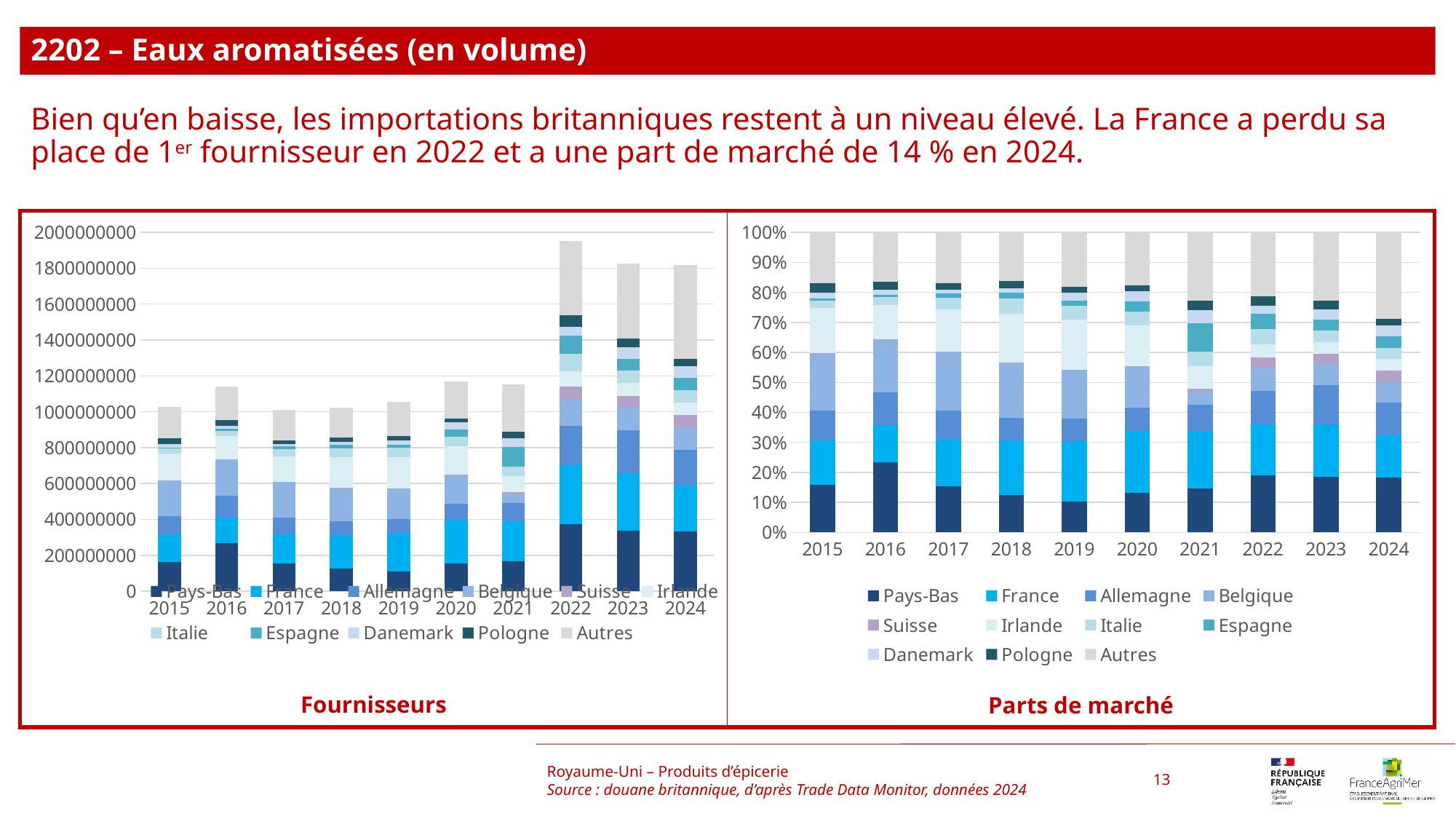
In the 'Fournisseurs' chart, is the total for 2023 greater or less than 1600000000? greater In the 'Parts de marché' chart, is the Pays-Bas share in 2016 greater or less than 20%? greater What is the title of the chart on the right side of the slide? Parts de marché What kind of chart is the 'Fournisseurs' chart on the left? stacked bar chart In the 'Fournisseurs' chart, which year has the larger total, 2021 or 2022? 2022 How many years are shown on the x axis of the 'Parts de marché' chart? 10 How many series does the legend of the 'Fournisseurs' chart list? 11 In the 'Parts de marché' chart, is the Pays-Bas share in 2019 greater or less than 20%? less In the 'Fournisseurs' chart, does the total rise or fall from 2021 to 2022? rise In the 'Fournisseurs' chart, which year has the tallest stacked bar? 2022